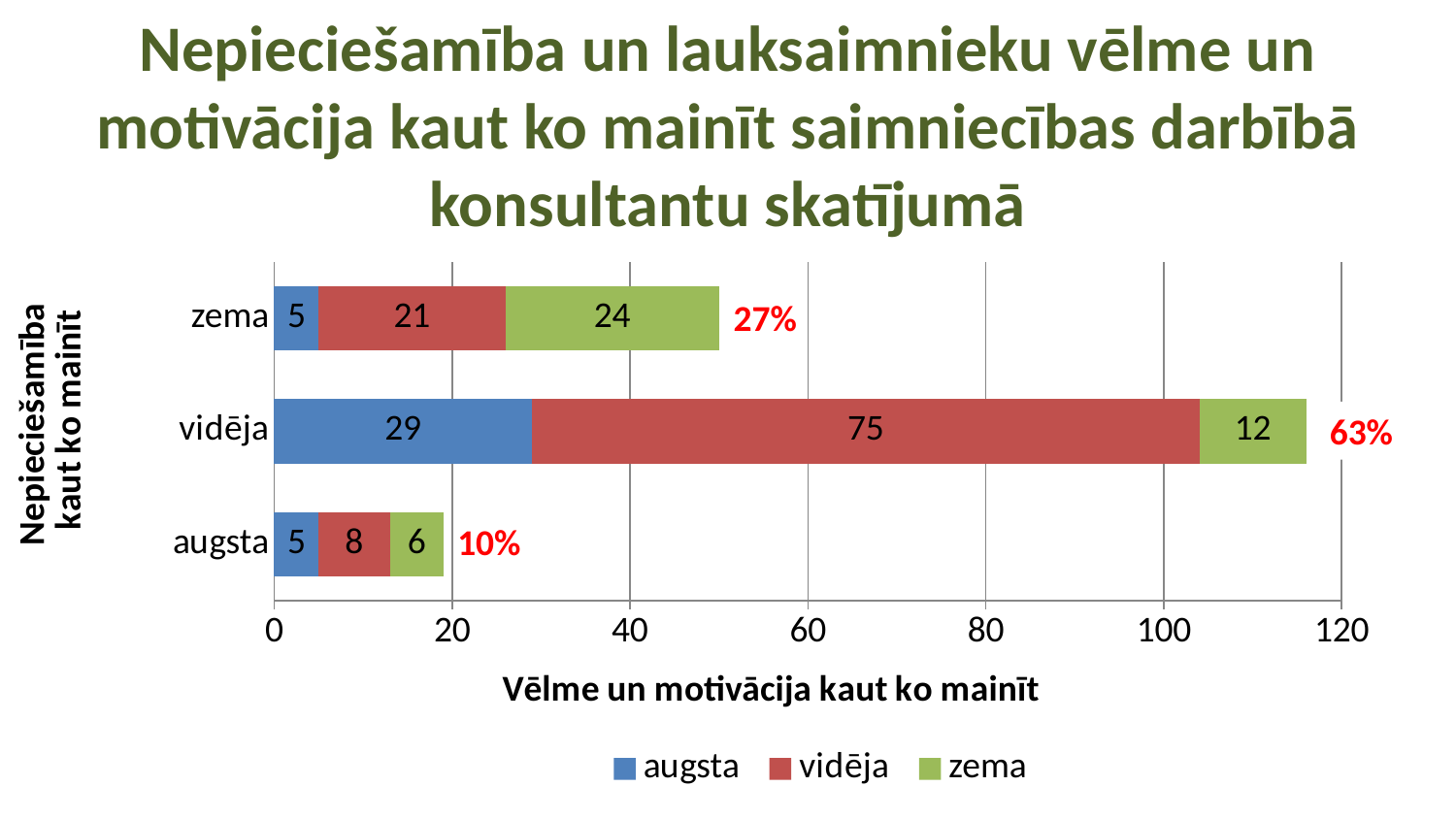
Which category has the shortest stacked bar overall? augsta How many categories are shown on the vertical axis? 3 How many series does the legend list? 3 What is the value of the 'vidēja' series for the 'vidēja' category? 75 What is the value of the 'augsta' series for the 'augsta' category? 5 What kind of chart is shown on the slide? Stacked bar chart What is the value of the 'zema' series for the 'zema' category? 24 What is the total of the stacked bar for the 'augsta' category? 19 Which category has the longest stacked bar overall? vidēja What percentage label is shown next to the 'vidēja' bar? 63% What is the total of the stacked bar for the 'vidēja' category? 116 What is the difference between the 'vidēja' series values for the 'vidēja' and 'zema' categories? 54